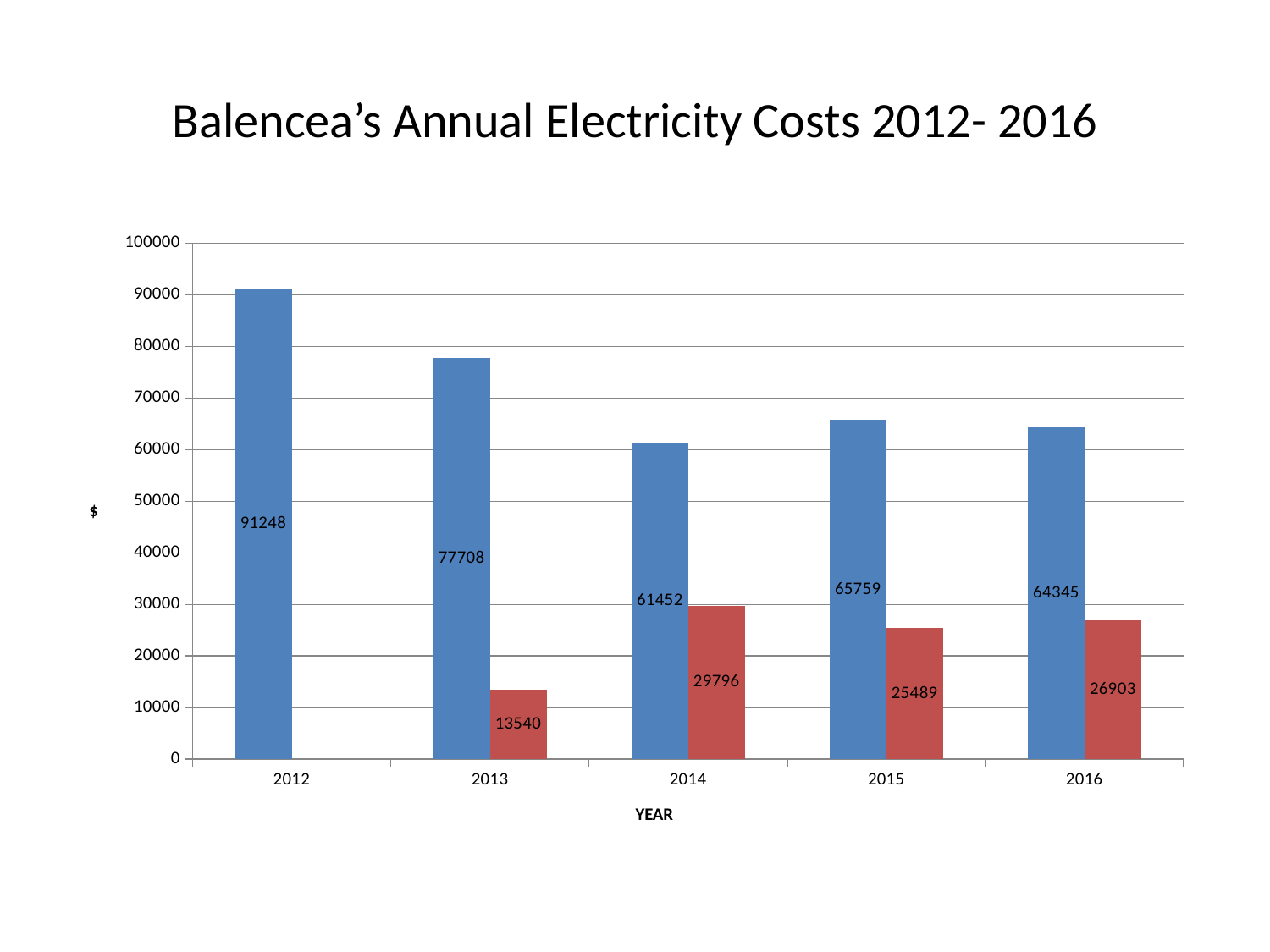
Is the value of the blue bar for 2013 greater or less than 80000? less Which year has the larger blue bar, 2015 or 2016? 2015 In which year is the blue bar highest? 2012 What is the value of the blue bar for 2012? 91248 What is the value of the red bar for 2014? 29796 What is the difference between the blue bar values for 2012 and 2013? 13540 In which year is the red bar lowest? 2013 How many years are shown on the x axis? 5 In 2014, how much larger is the blue bar value than the red bar value? 31656 In which year is the blue bar lowest? 2014 What kind of chart is shown on the slide? bar chart In which year is the red bar highest? 2014